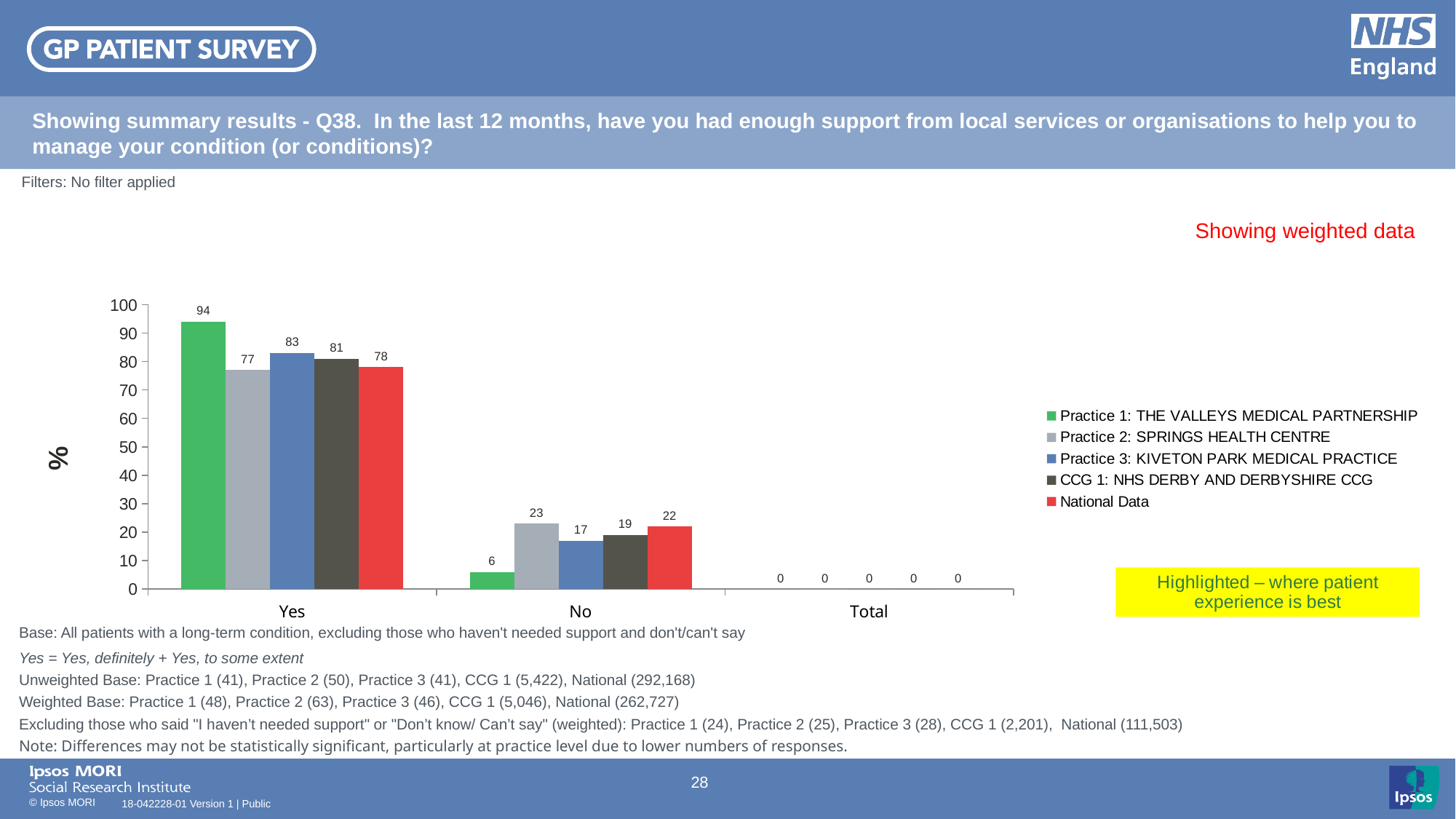
What value is shown for all series in the Total category? 0 Which series has the highest value in the Yes category? Practice 1: THE VALLEYS MEDICAL PARTNERSHIP What is the label on the y axis of the chart? % How many categories are shown on the x axis? 3 Which is larger in the No category: Practice 2: SPRINGS HEALTH CENTRE or CCG 1: NHS DERBY AND DERBYSHIRE CCG? Practice 2: SPRINGS HEALTH CENTRE How many series does the legend list? 5 What is the difference between Practice 1 and Practice 2 in the Yes category? 17 What is the value for National Data in the No category? 22 Which series has the lowest value in the No category? Practice 1: THE VALLEYS MEDICAL PARTNERSHIP What is the value for Practice 3: KIVETON PARK MEDICAL PRACTICE in the Yes category? 83 What kind of chart is shown on the slide? Bar chart What is the value for Practice 1: THE VALLEYS MEDICAL PARTNERSHIP in the Yes category? 94